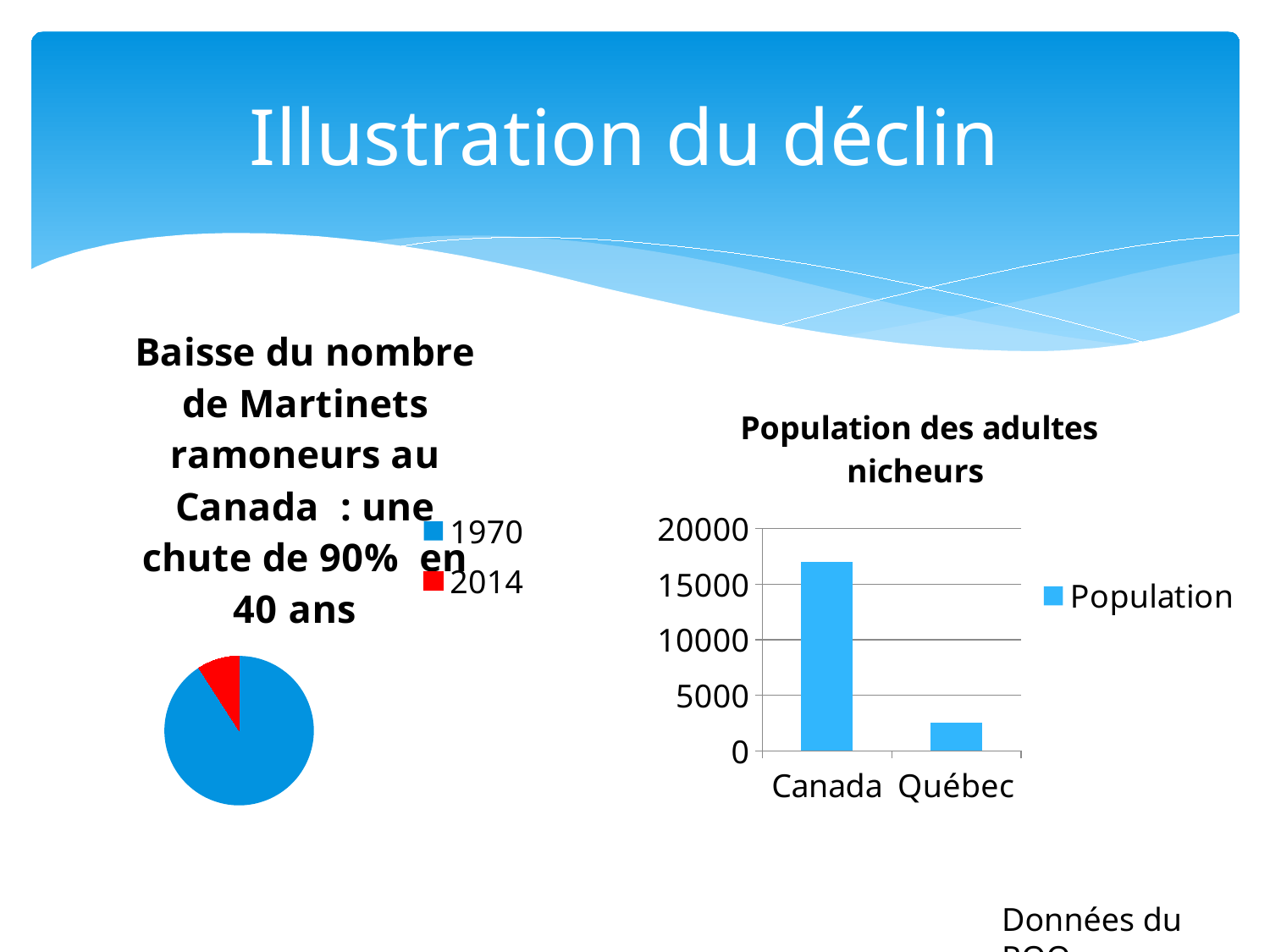
In the chart titled "Population des adultes nicheurs", which is larger, the value for Canada or the value for Québec? Canada In the chart titled "Population des adultes nicheurs", is the value for Québec greater or less than 5000? less In the pie chart on the left of the slide, which slice is larger, 1970 or 2014? 1970 In the chart titled "Population des adultes nicheurs", how many series does the legend list? 1 In the chart titled "Population des adultes nicheurs", which category has the highest value? Canada In the chart titled "Population des adultes nicheurs", is the value for Canada greater or less than 15000? greater In the chart titled "Population des adultes nicheurs", how many categories are shown on the x axis? 2 What kind of chart is the chart titled "Population des adultes nicheurs"? bar chart In the pie chart on the left of the slide, what colour is the slice for 2014? red In the chart titled "Population des adultes nicheurs", is the value for Canada greater or less than 20000? less What kind of chart is the chart on the left of the slide, with the legend entries 1970 and 2014? pie chart In the chart titled "Population des adultes nicheurs", which category has the lowest value? Québec